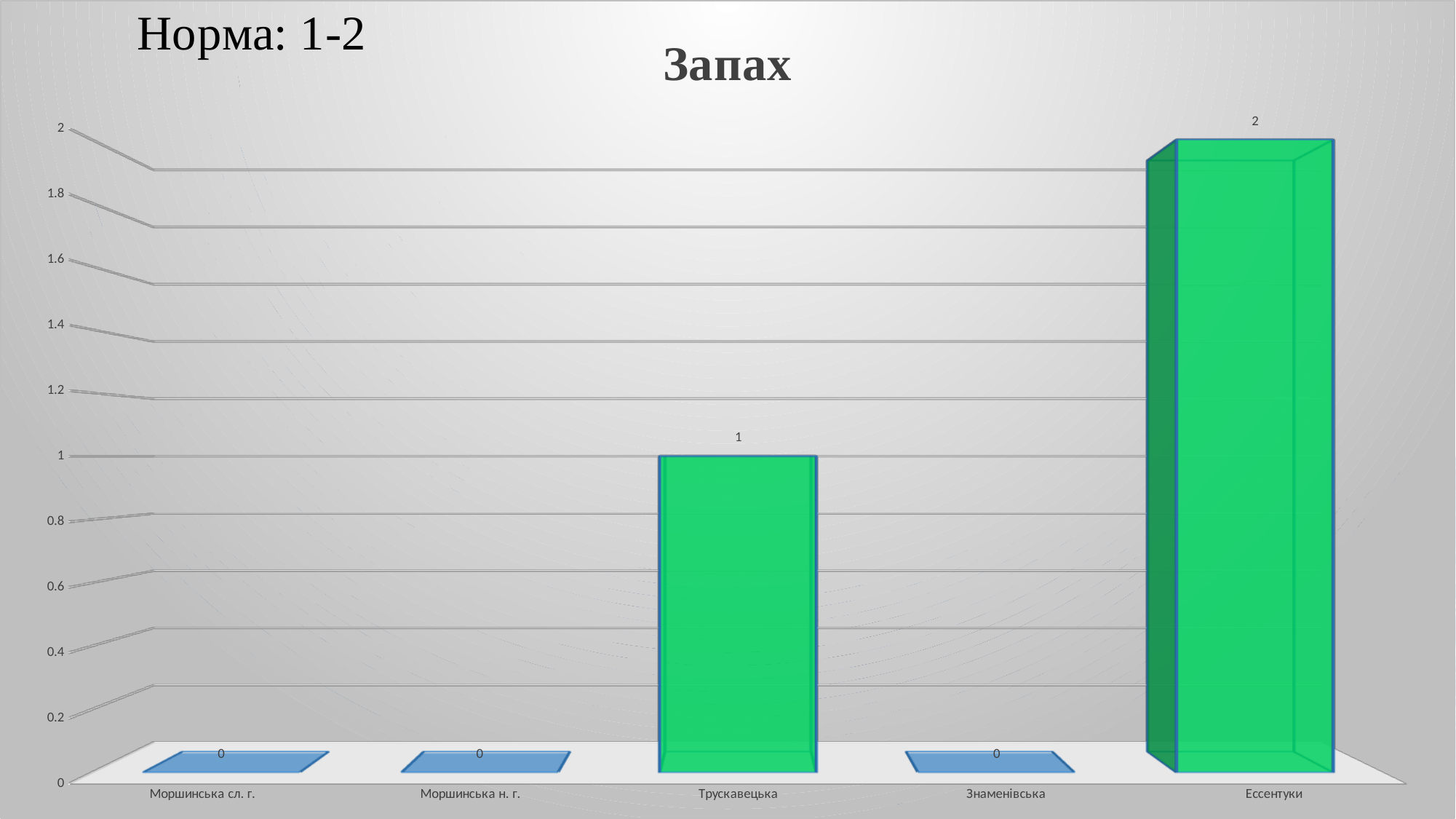
How many categories have a value of 0? 3 What is the value for Ессентуки? 2 What is the value for Моршинська н. г.? 0 What is the title of the chart? Запах Which category has the highest value? Ессентуки What is the value for Знаменівська? 0 What is the maximum value shown on the vertical axis? 2 How many categories are shown on the x axis? 5 Which is larger, the value for Трускавецька or the value for Знаменівська? Трускавецька What is the difference between the values for Ессентуки and Трускавецька? 1 What kind of chart is shown on the slide? Bar chart What is the value for Трускавецька? 1